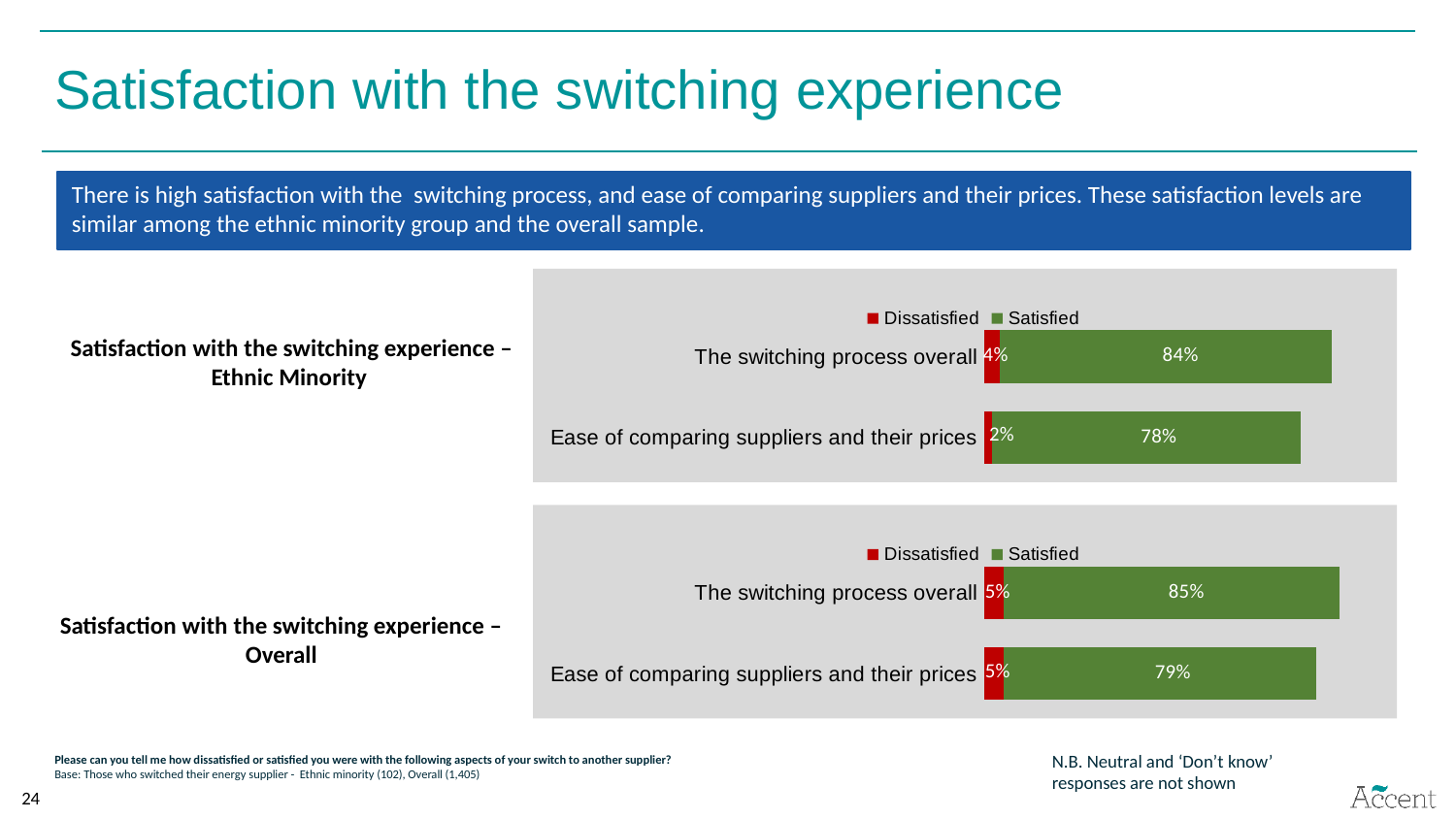
How many aspects are shown in the 'Satisfaction with the switching experience – Ethnic Minority' chart? 2 In the 'Satisfaction with the switching experience – Overall' chart, what is the difference between the satisfied percentages for the switching process overall and the ease of comparing suppliers and their prices? 6% In the 'Satisfaction with the switching experience – Overall' chart, which aspect has the lowest satisfied percentage? Ease of comparing suppliers and their prices How many series does the legend of the 'Satisfaction with the switching experience – Overall' chart list? 2 In the 'Satisfaction with the switching experience – Ethnic Minority' chart, what percentage were satisfied with the switching process overall? 84% In the 'Satisfaction with the switching experience – Overall' chart, what percentage were dissatisfied with the switching process overall? 5% In the 'Satisfaction with the switching experience – Ethnic Minority' chart, which aspect has the highest satisfied percentage? The switching process overall In the 'Satisfaction with the switching experience – Ethnic Minority' chart, what is the difference between the satisfied percentages for the switching process overall and the ease of comparing suppliers and their prices? 6% Is the satisfied percentage for the switching process overall higher in the Ethnic Minority chart or the Overall chart? Overall In the 'Satisfaction with the switching experience – Overall' chart, what percentage were satisfied with the ease of comparing suppliers and their prices? 79% In the 'Satisfaction with the switching experience – Ethnic Minority' chart, what percentage were dissatisfied with the ease of comparing suppliers and their prices? 2% What type of chart is the 'Satisfaction with the switching experience – Overall' chart? Bar chart